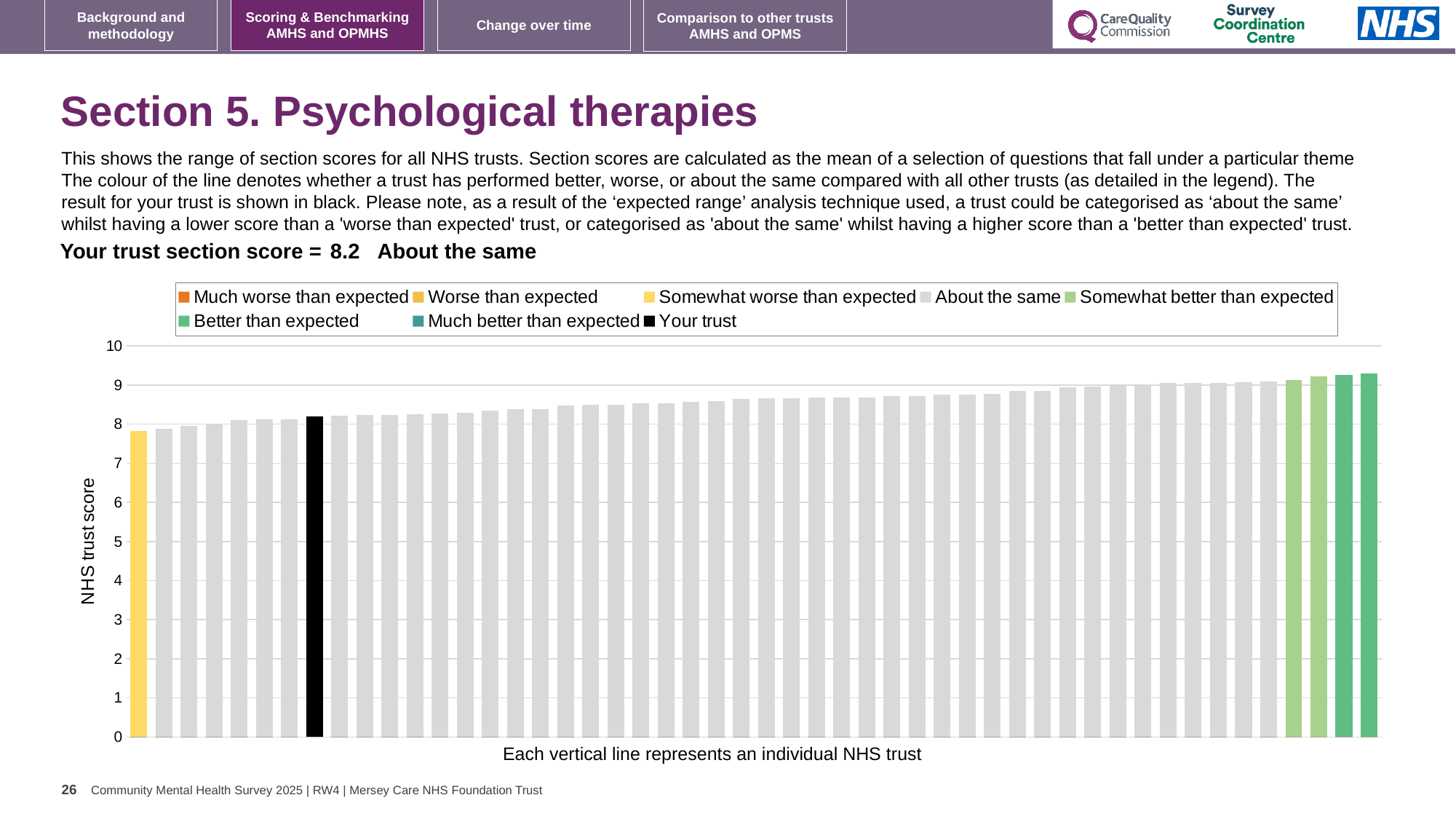
How many entries does the chart legend list? 8 What colour is the bar representing your trust? black Is the value of the leftmost (yellow) bar greater or less than 9? less How many bars are coloured black in the chart? 1 Which legend category does the tallest bar belong to? Better than expected How many green bars are there at the right end of the chart? 4 Is the value of the black 'Your trust' bar greater or less than 8? greater What is the label on the vertical axis of the chart? NHS trust score Is the value of the black 'Your trust' bar greater or less than 9? less What kind of chart is shown on the slide? bar chart What is the section score for your trust shown on the slide? 8.2